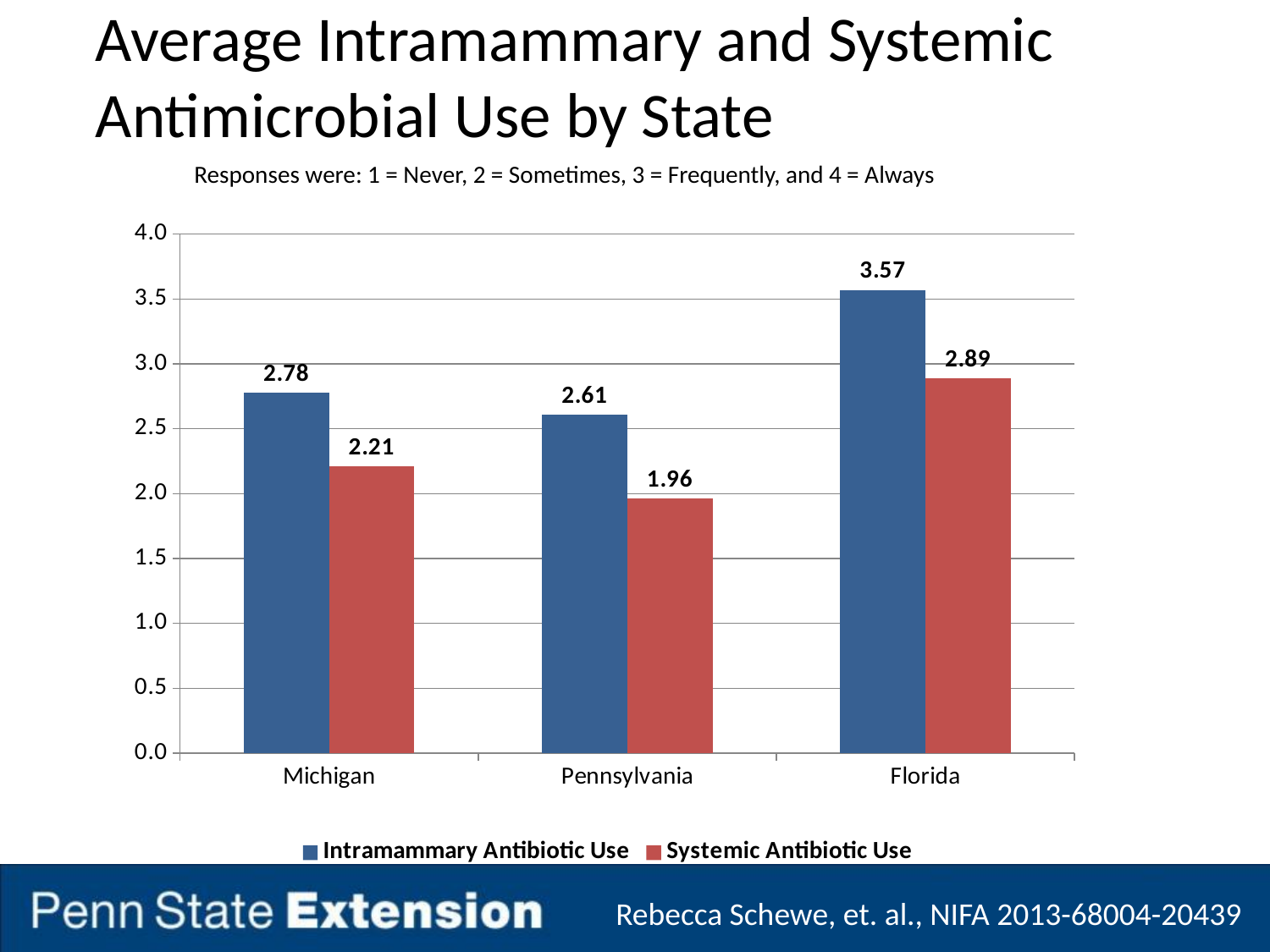
What is the Systemic Antibiotic Use value for Pennsylvania? 1.96 How many series does the legend list? 2 What kind of chart is shown on the slide? Bar chart Which state has the highest Intramammary Antibiotic Use value? Florida What is the difference between Intramammary Antibiotic Use and Systemic Antibiotic Use for Florida? 0.68 What is the Systemic Antibiotic Use value for Florida? 2.89 What is the difference between the Intramammary Antibiotic Use values for Michigan and Pennsylvania? 0.17 Which state has the lowest Systemic Antibiotic Use value? Pennsylvania What is the Intramammary Antibiotic Use value for Michigan? 2.78 Which is larger, Systemic Antibiotic Use for Michigan or Systemic Antibiotic Use for Florida? Florida How many states are shown on the x axis? 3 Which colour represents Systemic Antibiotic Use in the chart? Red